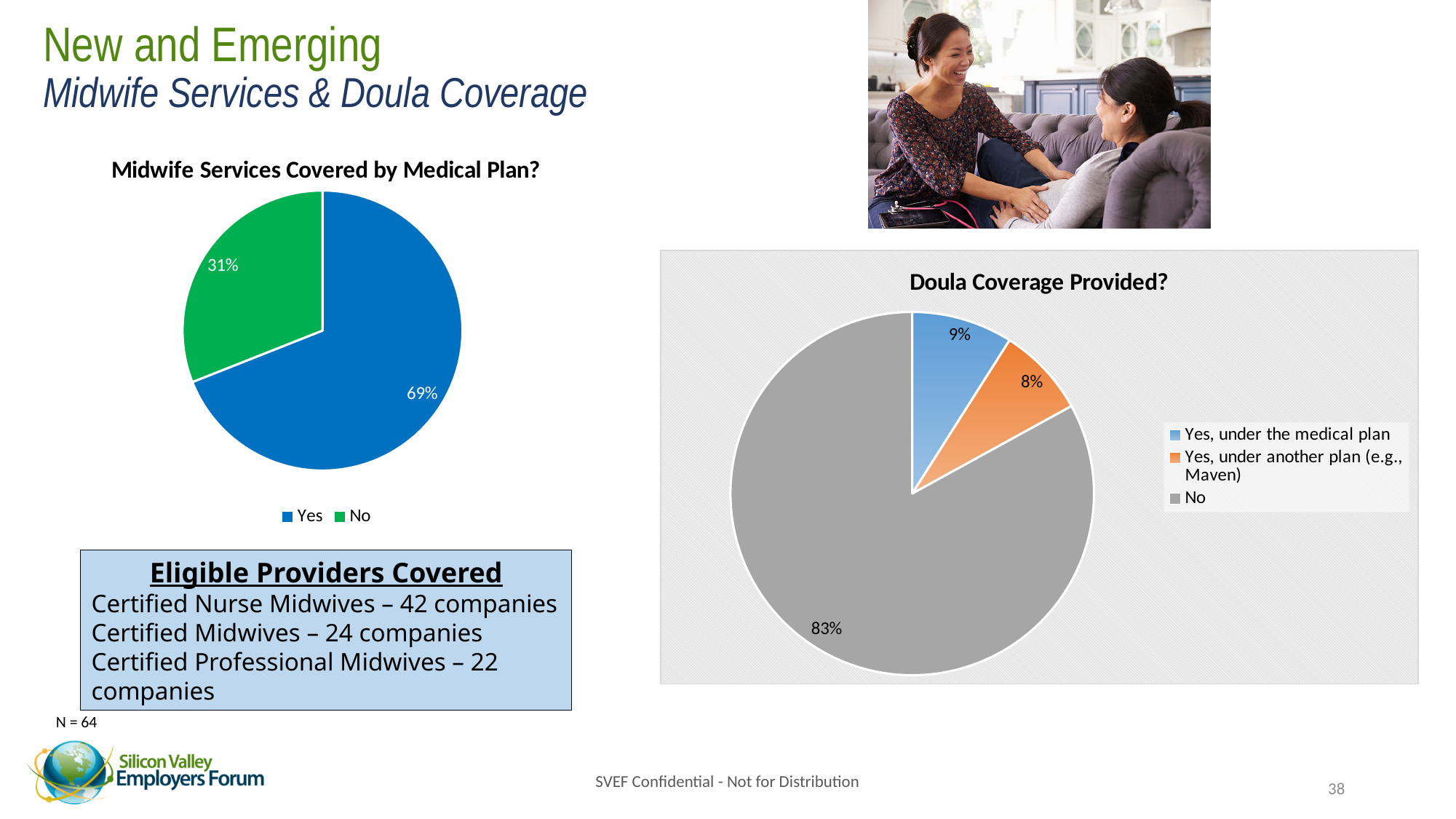
What kind of chart is 'Midwife Services Covered by Medical Plan?'? Pie chart In the 'Doula Coverage Provided?' chart, what colour is the 'No' slice? Grey In the 'Midwife Services Covered by Medical Plan?' chart, what is the difference between the 'Yes' and 'No' shares? 38% In the 'Doula Coverage Provided?' chart, what share of the pie is 'No'? 83% In the 'Doula Coverage Provided?' chart, which category has the largest slice? No In the 'Doula Coverage Provided?' chart, what share of the pie is 'Yes, under the medical plan'? 9% How many categories does the 'Doula Coverage Provided?' chart show? 3 How many entries does the legend of the 'Midwife Services Covered by Medical Plan?' chart list? 2 In the 'Midwife Services Covered by Medical Plan?' chart, which slice is larger, 'Yes' or 'No'? Yes In the 'Doula Coverage Provided?' chart, what share of the pie is 'Yes, under another plan (e.g., Maven)'? 8%